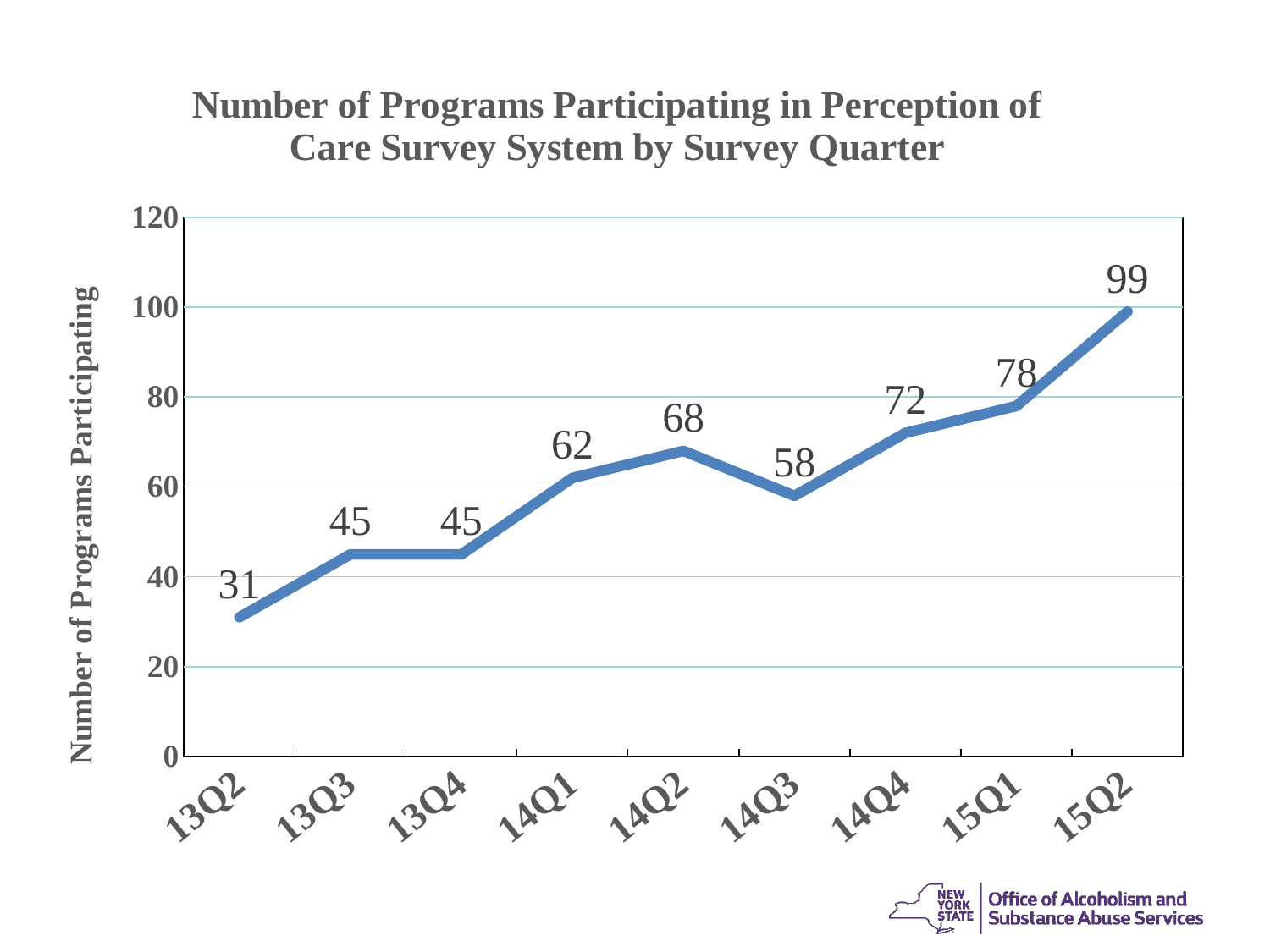
What is the difference in the number of programs participating between 15Q2 and 15Q1? 21 Which survey quarter has the lowest number of programs participating? 13Q2 Which survey quarter has the highest number of programs participating? 15Q2 What is the number of programs participating in 14Q2? 68 Which quarter has more programs participating, 14Q1 or 14Q3? 14Q1 What is the difference in the number of programs participating between 14Q2 and 14Q3? 10 What is the number of programs participating in 15Q1? 78 Overall, does the number of programs participating rise or fall from 13Q2 to 15Q2? Rise How many survey quarters are plotted on the chart? 9 What kind of chart is shown on the slide? Line chart What is the label of the vertical axis? Number of Programs Participating What is the number of programs participating in 13Q2? 31